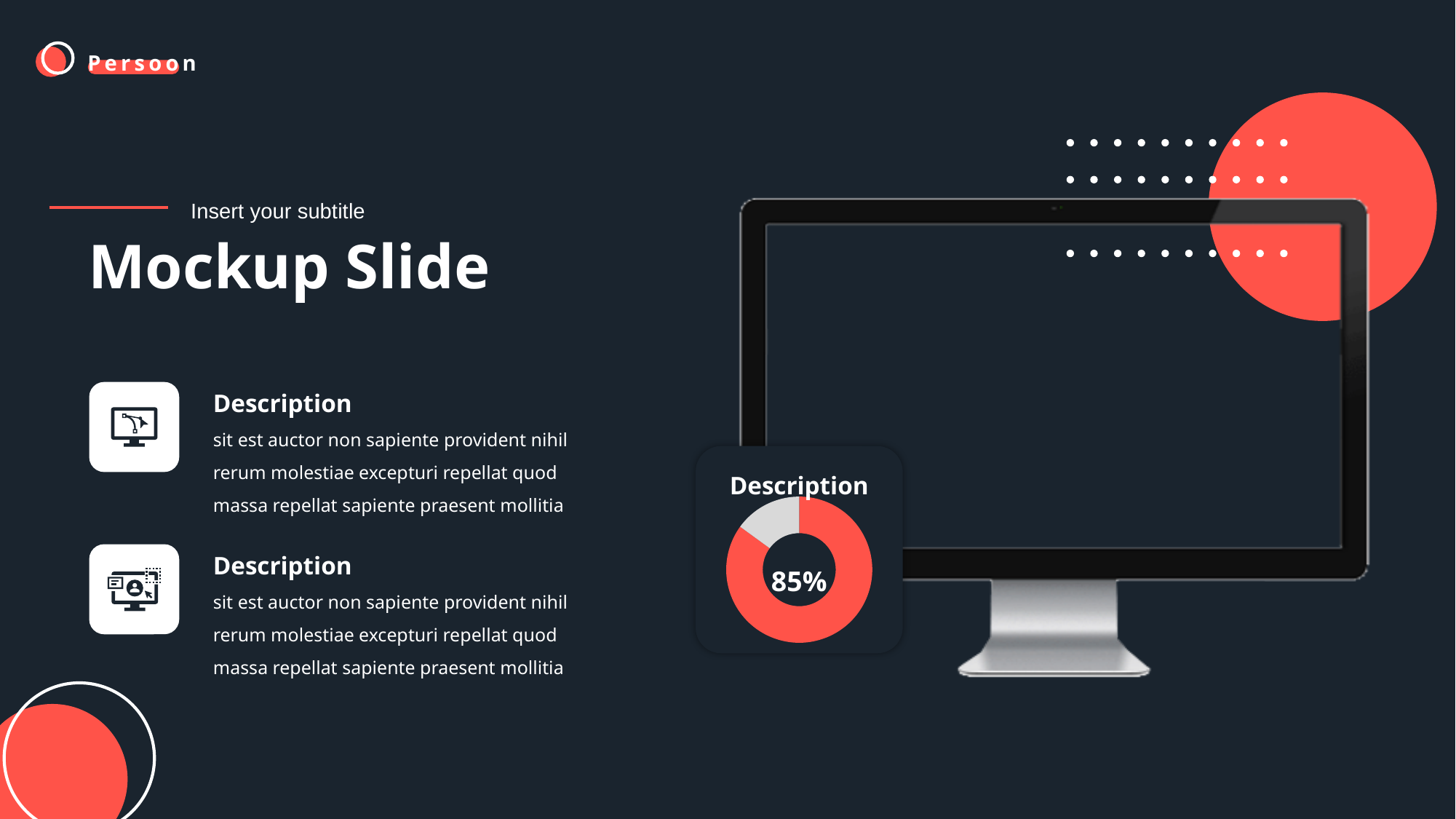
What share of the donut does the red slice represent? 85% Is the value shown in the donut chart greater or less than 50%? greater What kind of chart is shown on the slide? Donut chart What colour is the largest slice of the donut chart? Red What percentage is printed in the centre of the donut chart? 85% How many slices does the donut chart have? 2 Which slice of the donut chart is the smallest? The grey slice Which slice of the donut chart is larger, the red one or the grey one? Red What is the title shown above the donut chart? Description